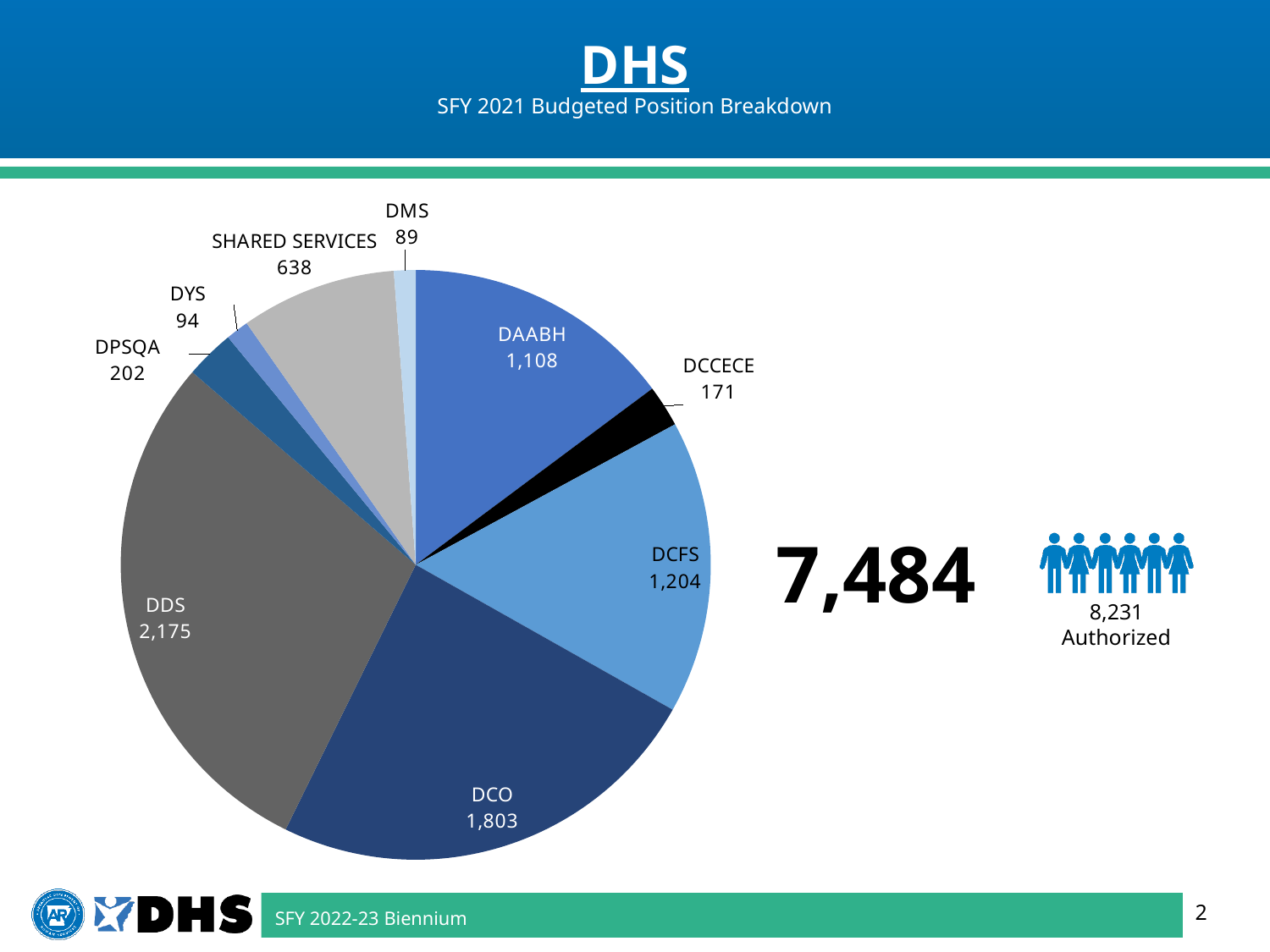
Which division has the smallest slice of the pie? DMS What is the value shown for DPSQA? 202 What kind of chart is shown on the slide? pie chart What is the difference between the DDS and DCO values? 372 Which division has the largest slice of the pie? DDS What is the value shown for SHARED SERVICES? 638 What is the value shown for DCO? 1,803 What is the subtitle of the chart under the DHS heading? SFY 2021 Budgeted Position Breakdown How many budgeted positions does DDS have? 2,175 What total number of budgeted positions is displayed next to the pie chart? 7,484 Which is larger, the value for DCFS or the value for DAABH? DCFS How many divisions are shown in the pie chart? 9